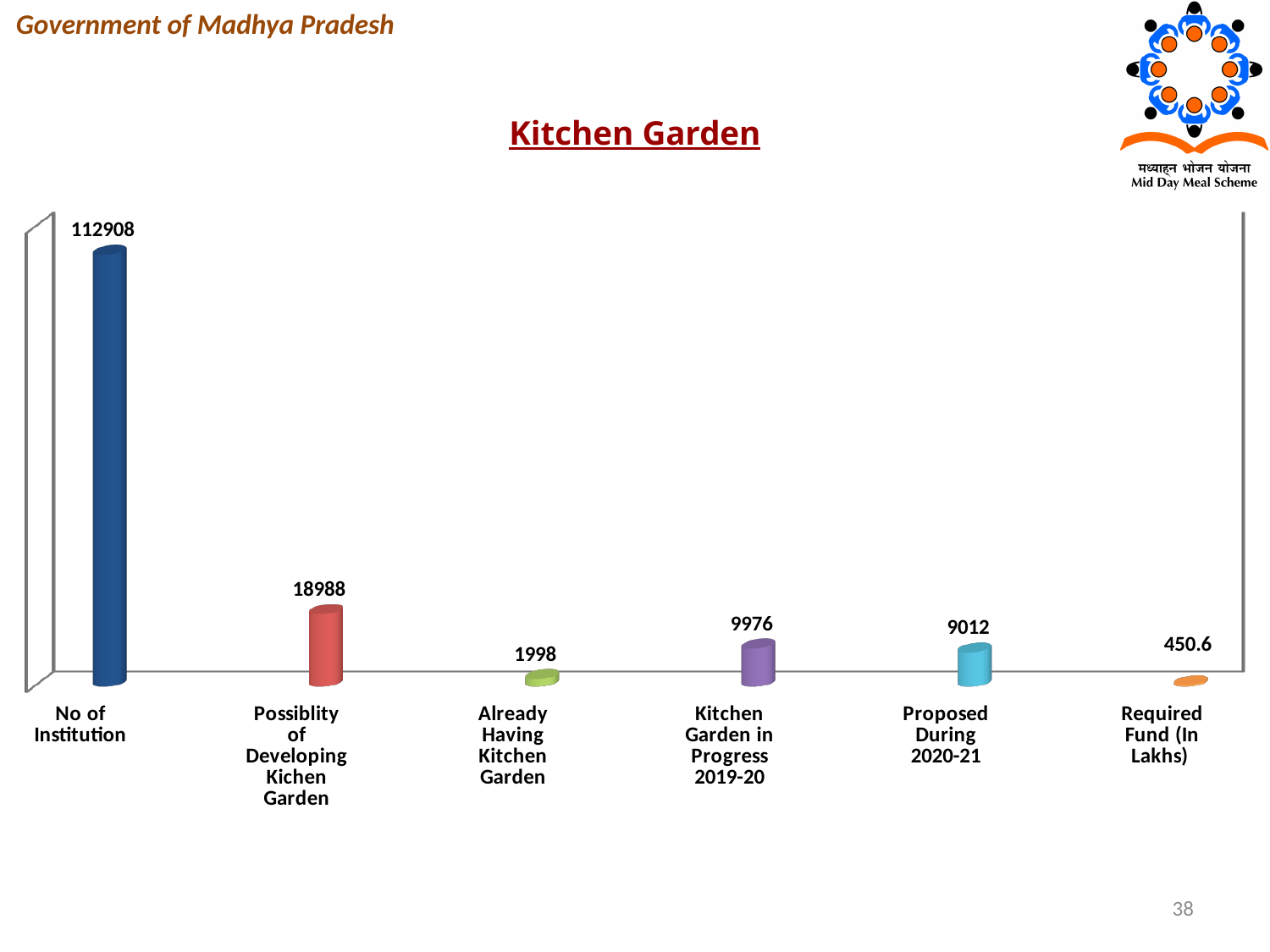
Which is larger: Possiblity of Developing Kichen Garden or Already Having Kitchen Garden? Possiblity of Developing Kichen Garden Which category has the highest value? No of Institution Which category has the lowest value? Required Fund (In Lakhs) What is the value for Kitchen Garden in Progress 2019-20? 9976 What is the value for Already Having Kitchen Garden? 1998 What is the value for Proposed During 2020-21? 9012 What is the title of the chart? Kitchen Garden What is the value for Possiblity of Developing Kichen Garden? 18988 How many categories are shown in the chart? 6 What is the value for No of Institution? 112908 What is the difference between Kitchen Garden in Progress 2019-20 and Proposed During 2020-21? 964 What is the value for Required Fund (In Lakhs)? 450.6